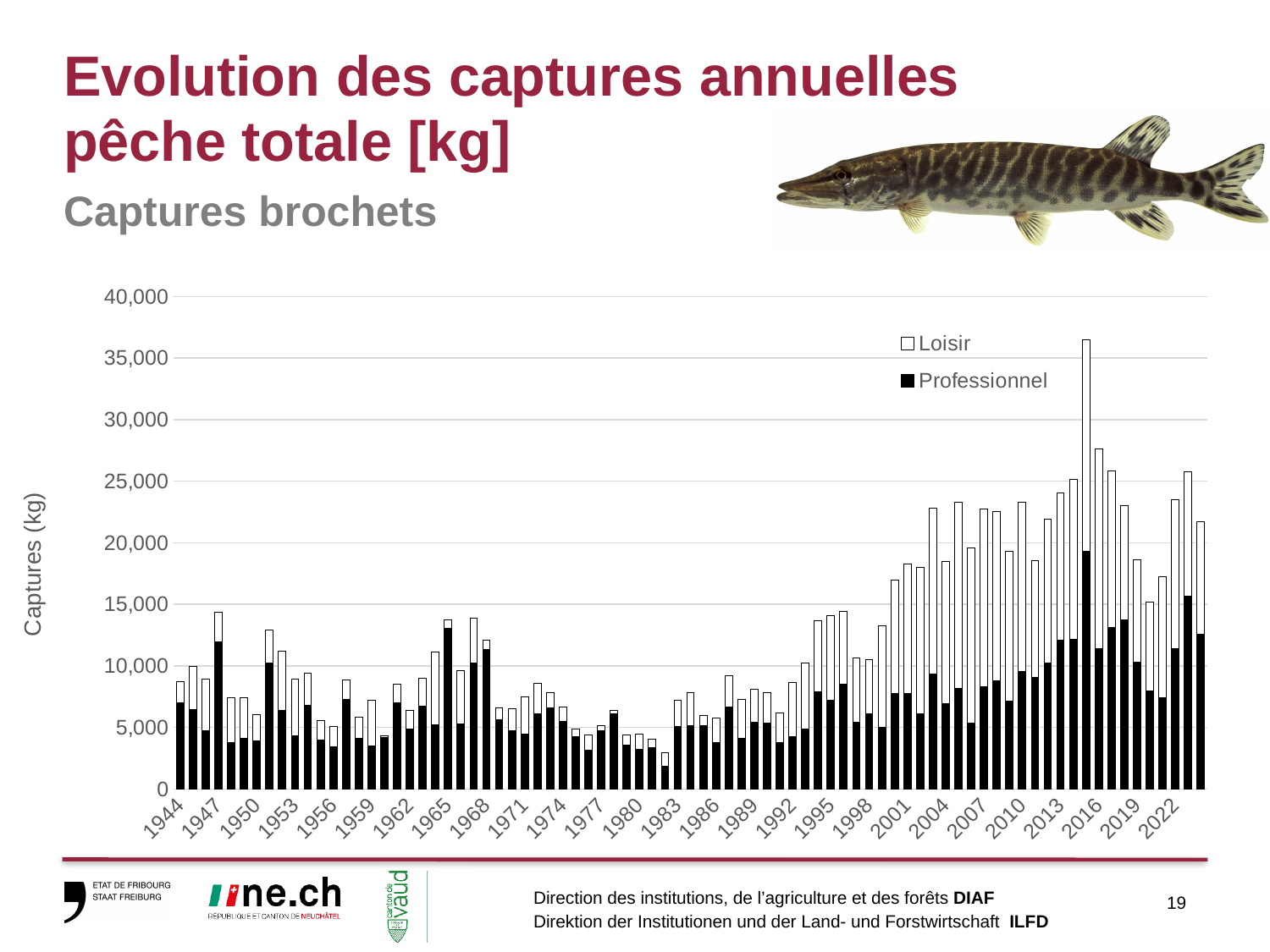
Is the total value for 1983 greater or less than 5,000? greater Which two series are listed in the chart's legend? Loisir and Professionnel Is the total value for 1947 greater or less than 10,000? greater Which year has the larger total catch, 1983 or 2022? 2022 Which series is drawn in black in the chart? Professionnel Is the total value for 2022 greater or less than 20,000? greater How many series does the chart's legend list? 2 What kind of chart is shown on the slide? Stacked bar chart Do the total catches generally rise or fall between 1983 and 2016? rise Which year has the larger total catch, 1947 or 1950? 1947